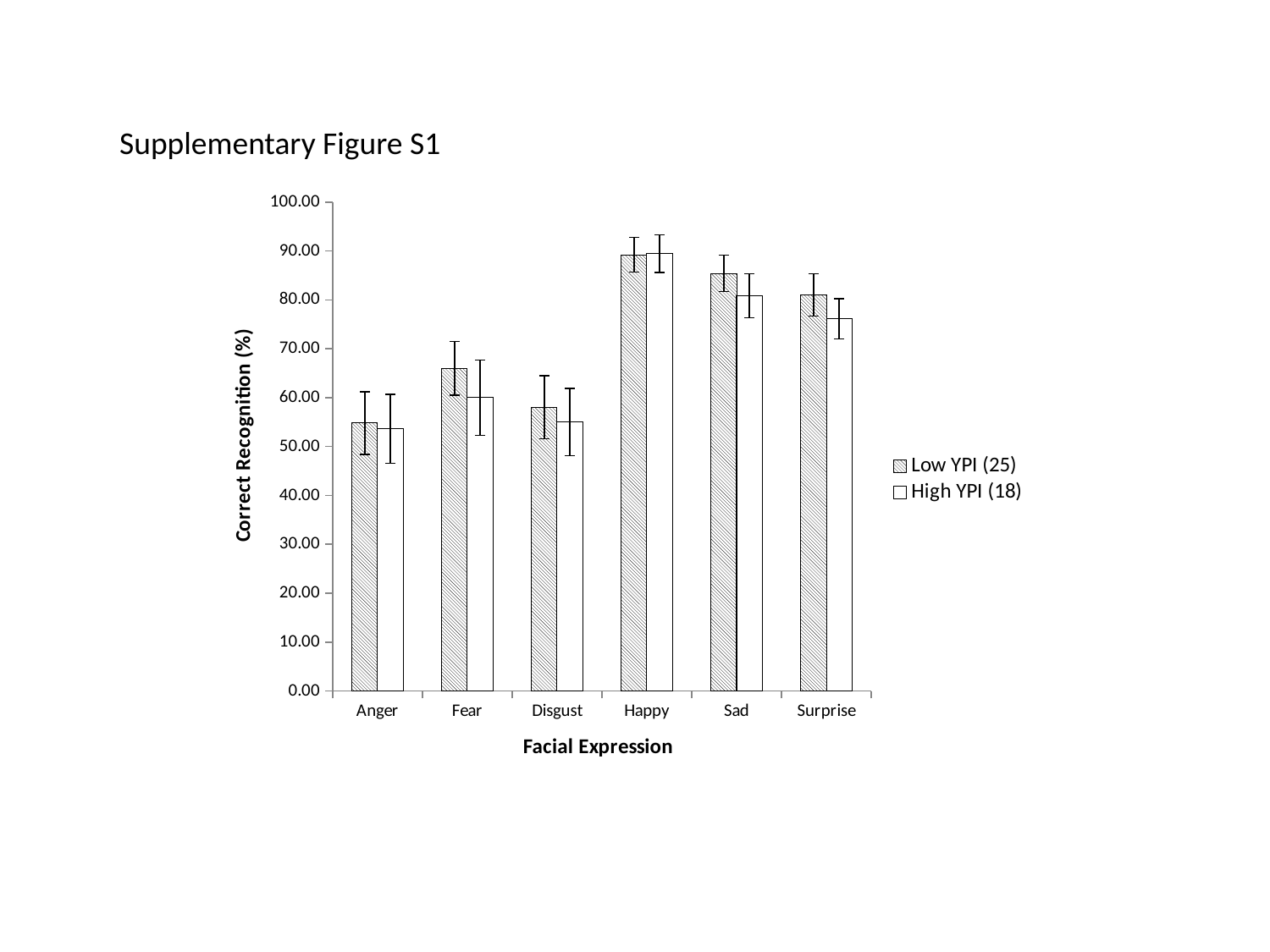
Is the Low YPI (25) value for Happy greater or less than 80.00? greater What is the title of the y axis? Correct Recognition (%) For Fear, which series has the higher correct recognition, Low YPI (25) or High YPI (18)? Low YPI (25) Which facial expression has the highest correct recognition for the High YPI (18) series? Happy Which facial expression has the highest correct recognition for the Low YPI (25) series? Happy How many facial expression categories are shown on the x axis? 6 What are the two entries listed in the legend? Low YPI (25) and High YPI (18) Is the Low YPI (25) value for Anger greater or less than 50.00? greater What kind of chart is shown on the slide? Bar chart For Surprise, which series has the higher correct recognition, Low YPI (25) or High YPI (18)? Low YPI (25) How many series does the legend list? 2 Is the High YPI (18) value for Fear greater or less than 70.00? less